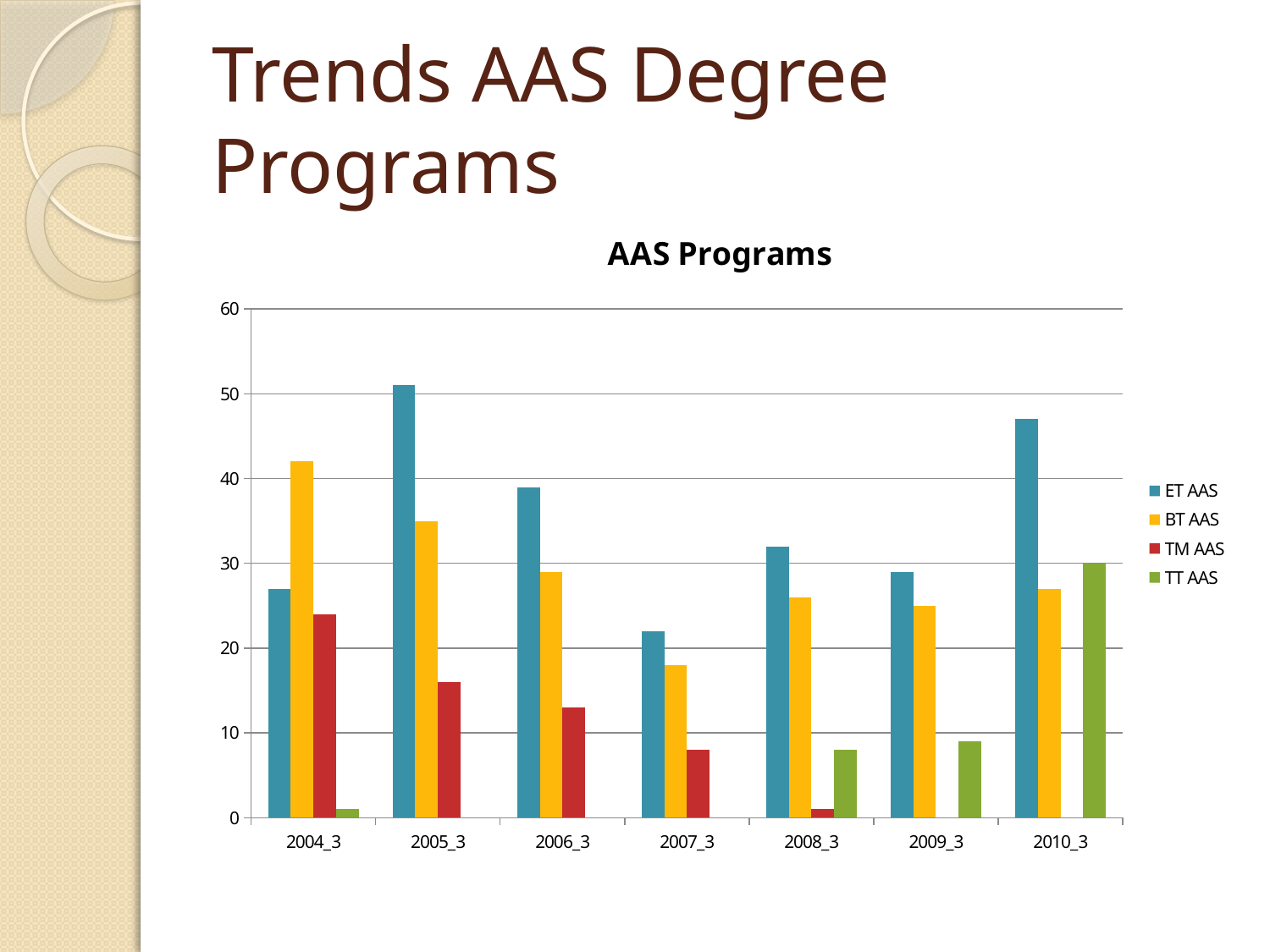
In which year is the ET AAS value lowest? 2007_3 How many year categories are shown on the x axis? 7 In which year is the ET AAS value highest? 2005_3 What is the title of the chart? AAS Programs Does the TM AAS value rise or fall from 2004_3 to 2008_3? Fall Is the value for BT AAS in 2007_3 greater or less than 20? less Is the value for ET AAS in 2010_3 greater or less than 40? greater Is the value for TT AAS in 2010_3 greater or less than 20? greater How many series does the legend list? 4 In which year is the BT AAS value highest? 2004_3 What kind of chart is shown on the slide? Bar chart In 2004_3, which is larger: ET AAS or BT AAS? BT AAS